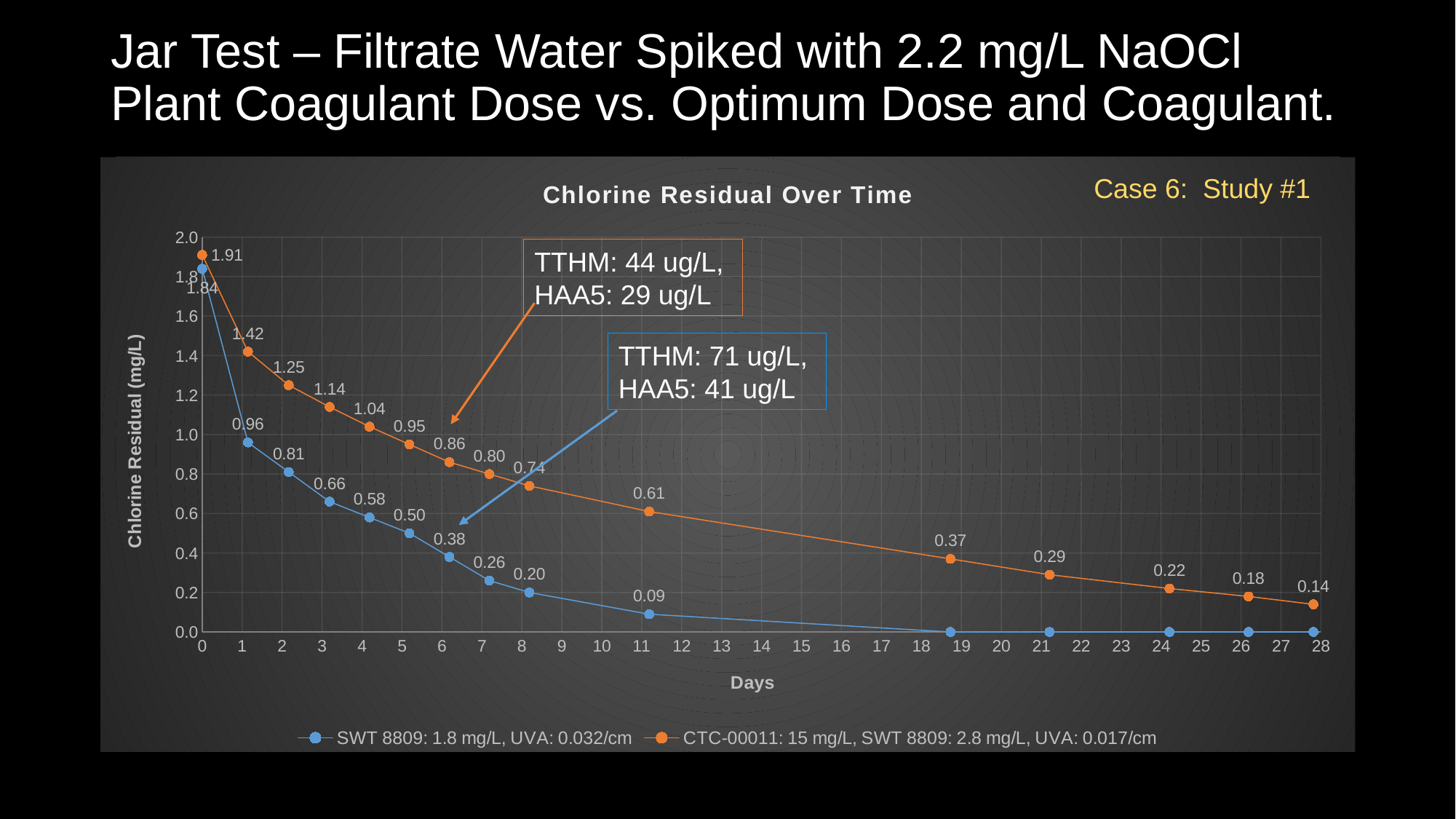
What is the title of the chart? Chlorine Residual Over Time Do the chlorine residual values rise or fall as the days increase? fall What type of chart is shown on the slide? line chart What is the first (day 0) chlorine residual value for the SWT 8809: 1.8 mg/L series? 1.84 What is the highest labeled value on the chart? 1.91 What is the first (day 0) chlorine residual value for the CTC-00011 / SWT 8809 2.8 mg/L series? 1.91 What is the labeled value of the SWT 8809: 1.8 mg/L series at its point near day 11? 0.09 How many series does the legend list? 2 Which series has the higher chlorine residual at the point near day 11? CTC-00011: 15 mg/L, SWT 8809: 2.8 mg/L, UVA: 0.017/cm What is the difference between the two series at their second data points (1.42 vs 0.96)? 0.46 Is the value of the SWT 8809: 1.8 mg/L series at the point near day 19 greater or less than 0.2? less What is the last labeled value (at day 28) for the CTC-00011 / SWT 8809 2.8 mg/L series? 0.14